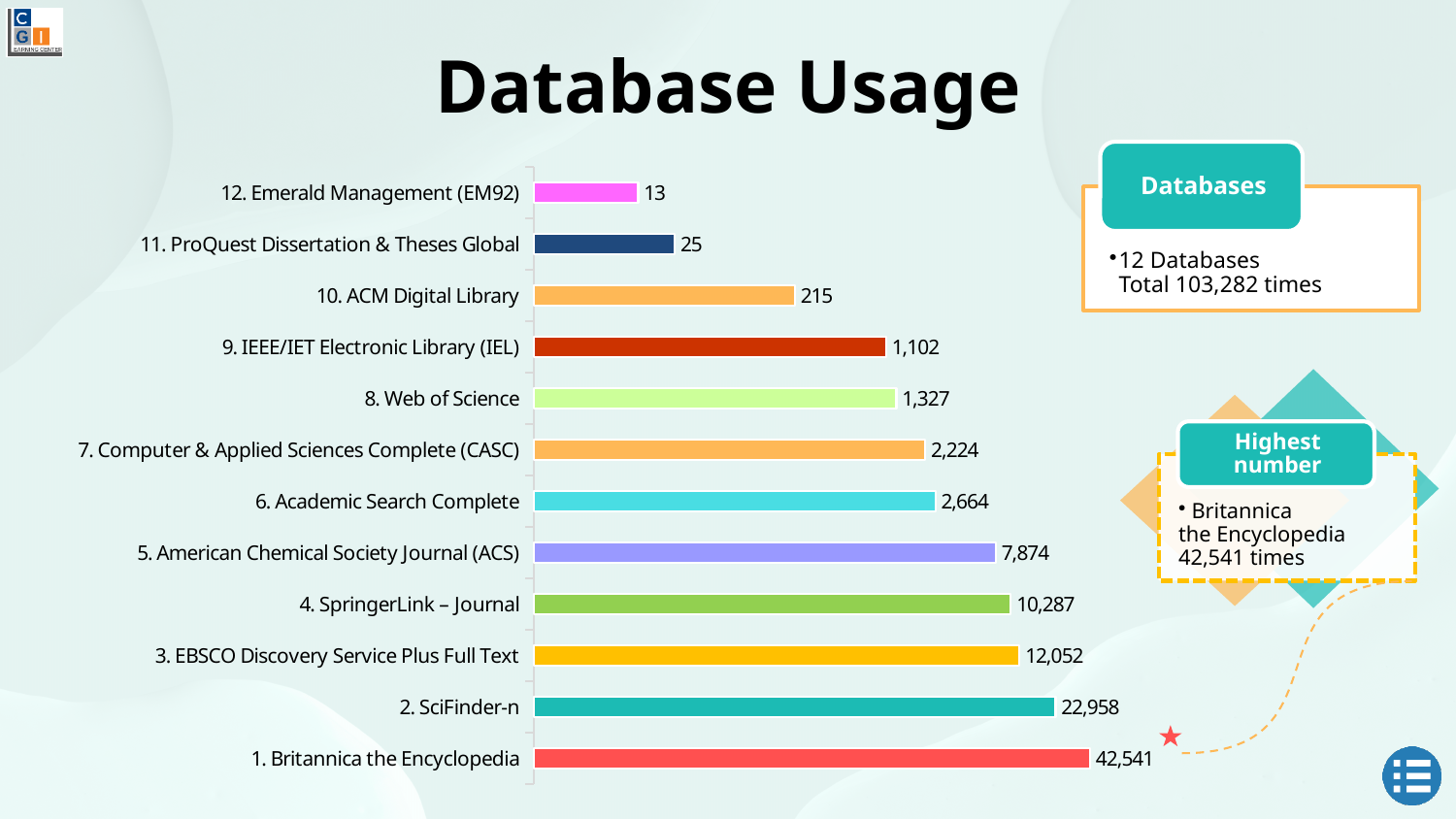
What is the difference in usage between Britannica the Encyclopedia and SciFinder-n? 19,583 Which database has the lowest usage? Emerald Management (EM92) How many databases are shown in the chart? 12 What is the title of the slide? Database Usage What is the usage value for Web of Science? 1,327 Which has higher usage, IEEE/IET Electronic Library (IEL) or ProQuest Dissertation & Theses Global? IEEE/IET Electronic Library (IEL) Which has higher usage, Academic Search Complete or Computer & Applied Sciences Complete (CASC)? Academic Search Complete What is the difference in usage between EBSCO Discovery Service Plus Full Text and SpringerLink – Journal? 1,765 What is the usage value for SciFinder-n? 22,958 Which database has the highest usage? Britannica the Encyclopedia What type of chart is shown on the slide? Bar chart What is the usage value for ACM Digital Library? 215